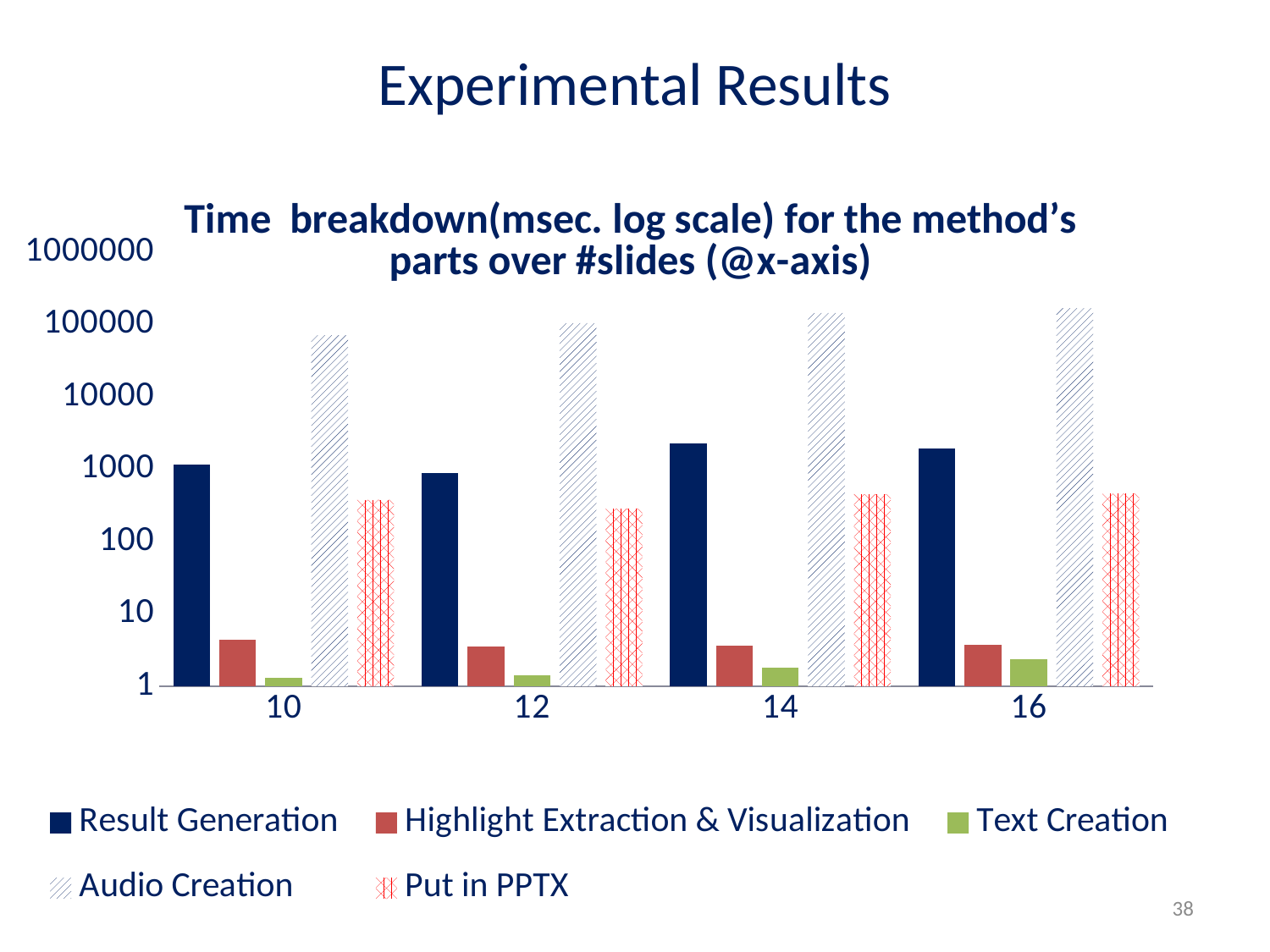
How many categories are shown on the x axis? 4 How many series does the legend list? 5 At which number of slides is the Result Generation value lowest? 12 Which series has the highest value at 10 slides? Audio Creation Which series is represented by the solid dark blue bars? Result Generation Is the value for Audio Creation at 16 slides greater or less than 100000? greater Is the value for Audio Creation at 10 slides greater or less than 100000? less What kind of chart is shown on the slide? bar chart Is the value for Put in PPTX at 10 slides greater or less than 100? greater What is the title of the chart? Time breakdown(msec. log scale) for the method's parts over #slides (@x-axis) Does the Audio Creation value rise or fall as the number of slides increases from 10 to 16? rise